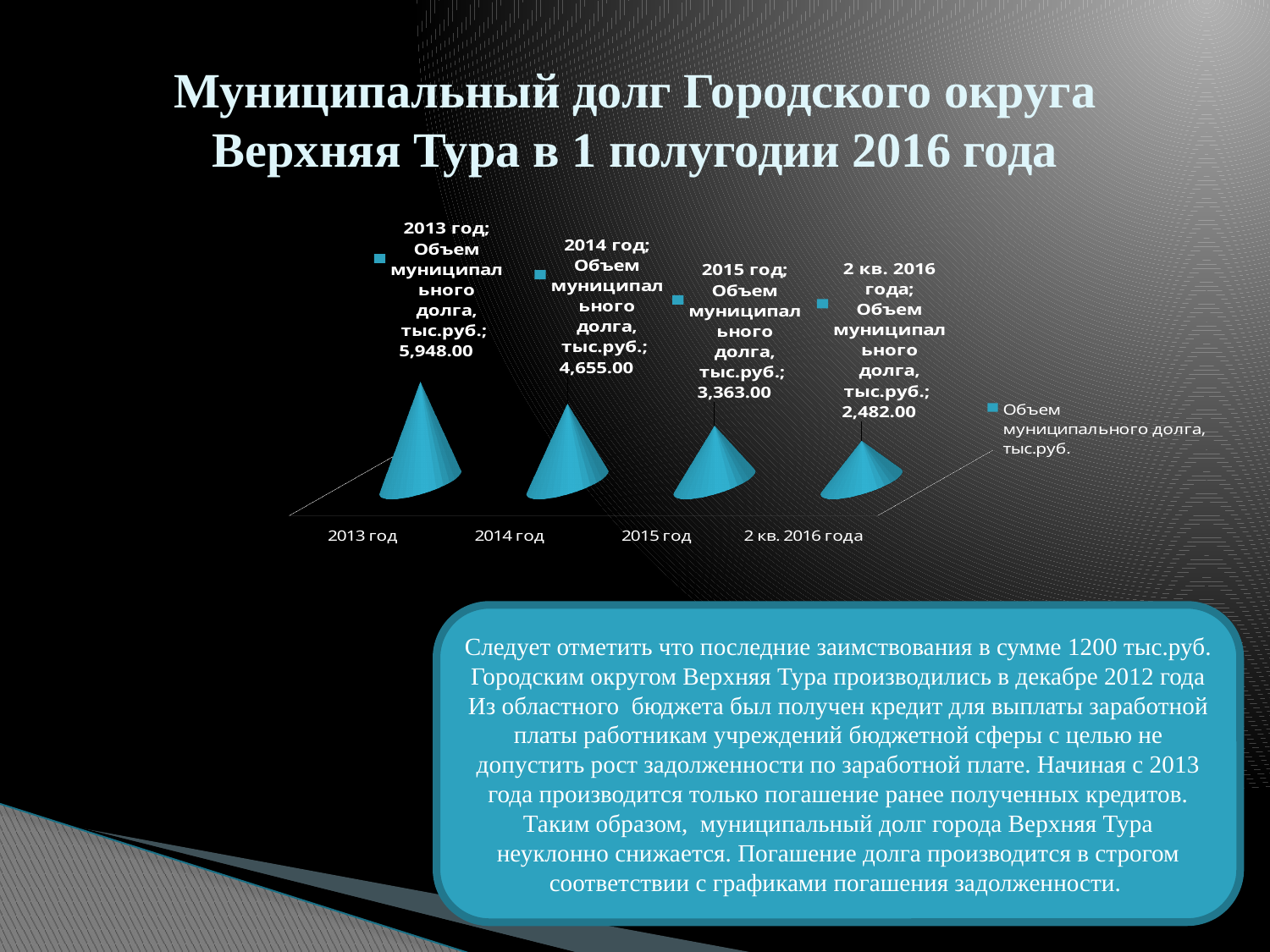
Do the values rise or fall from 2013 год to 2 кв. 2016 года? fall Which is larger, the value for 2014 год or the value for 2015 год? 2014 год Which category has the highest value? 2013 год What is the difference between the values for 2013 год and 2 кв. 2016 года? 3,466.00 What is the value for 2014 год? 4,655.00 Which category has the lowest value? 2 кв. 2016 года What is the value for 2 кв. 2016 года? 2,482.00 What is the value for 2015 год? 3,363.00 What is the difference between the values for 2013 год and 2014 год? 1,293.00 How many series does the legend list? 1 How many categories are shown on the x axis? 4 What is the value for 2013 год? 5,948.00